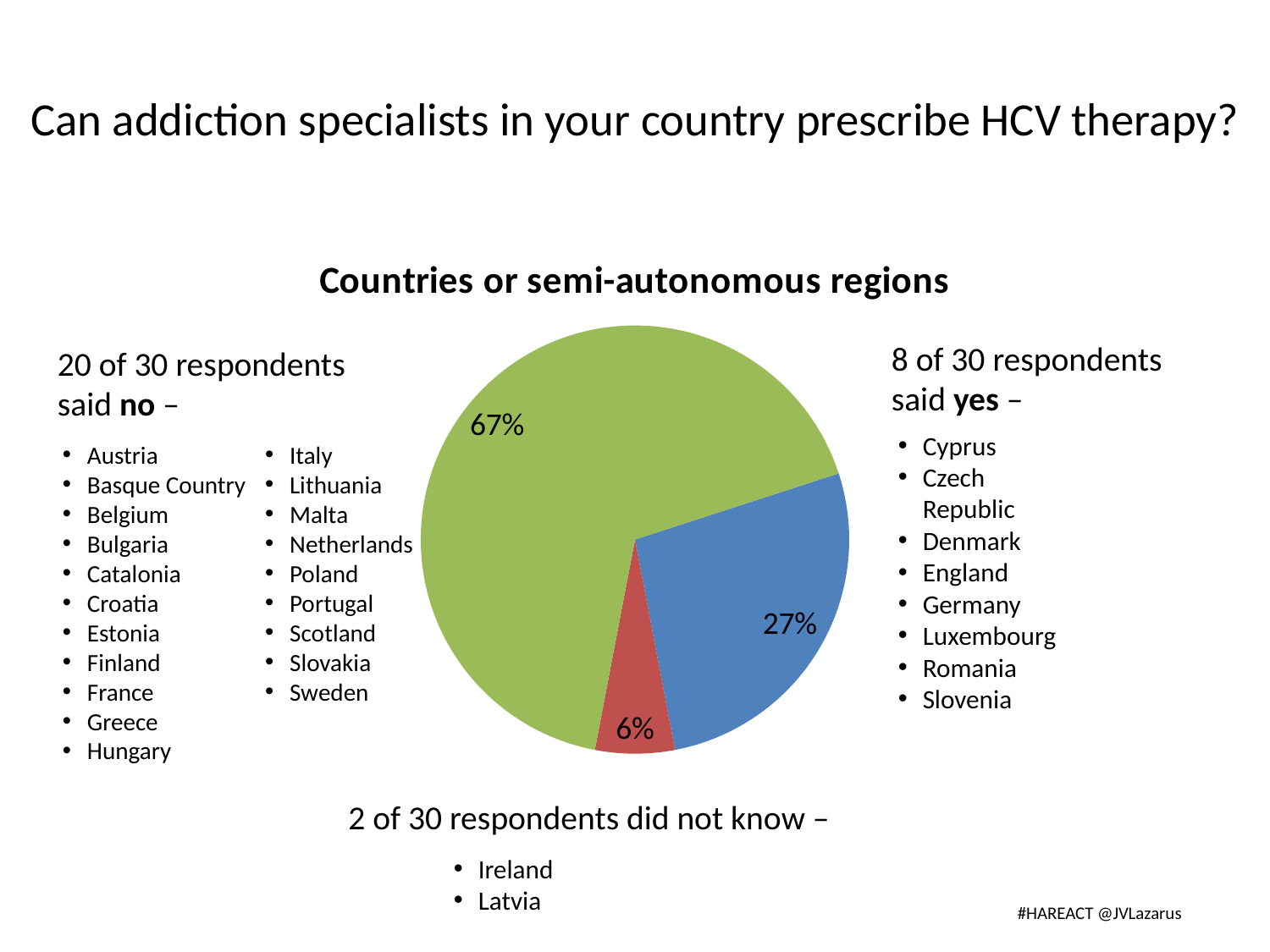
What share of the pie corresponds to respondents who said yes? 27% What percentage is shown on the red slice of the pie? 6% What is the difference in percentage points between the largest and the second-largest slice? 40 What percentage is shown on the smallest slice of the pie? 6% How many slices does the pie chart have? 3 What percentage is shown on the blue slice of the pie? 27% What percentage is shown on the largest slice of the pie? 67% What share of the pie corresponds to respondents who said no? 67% What kind of chart is shown on the slide? pie chart What is the title of the chart? Countries or semi-autonomous regions What colour is the largest slice of the pie? green Which slice is larger, the blue slice or the red slice? the blue slice